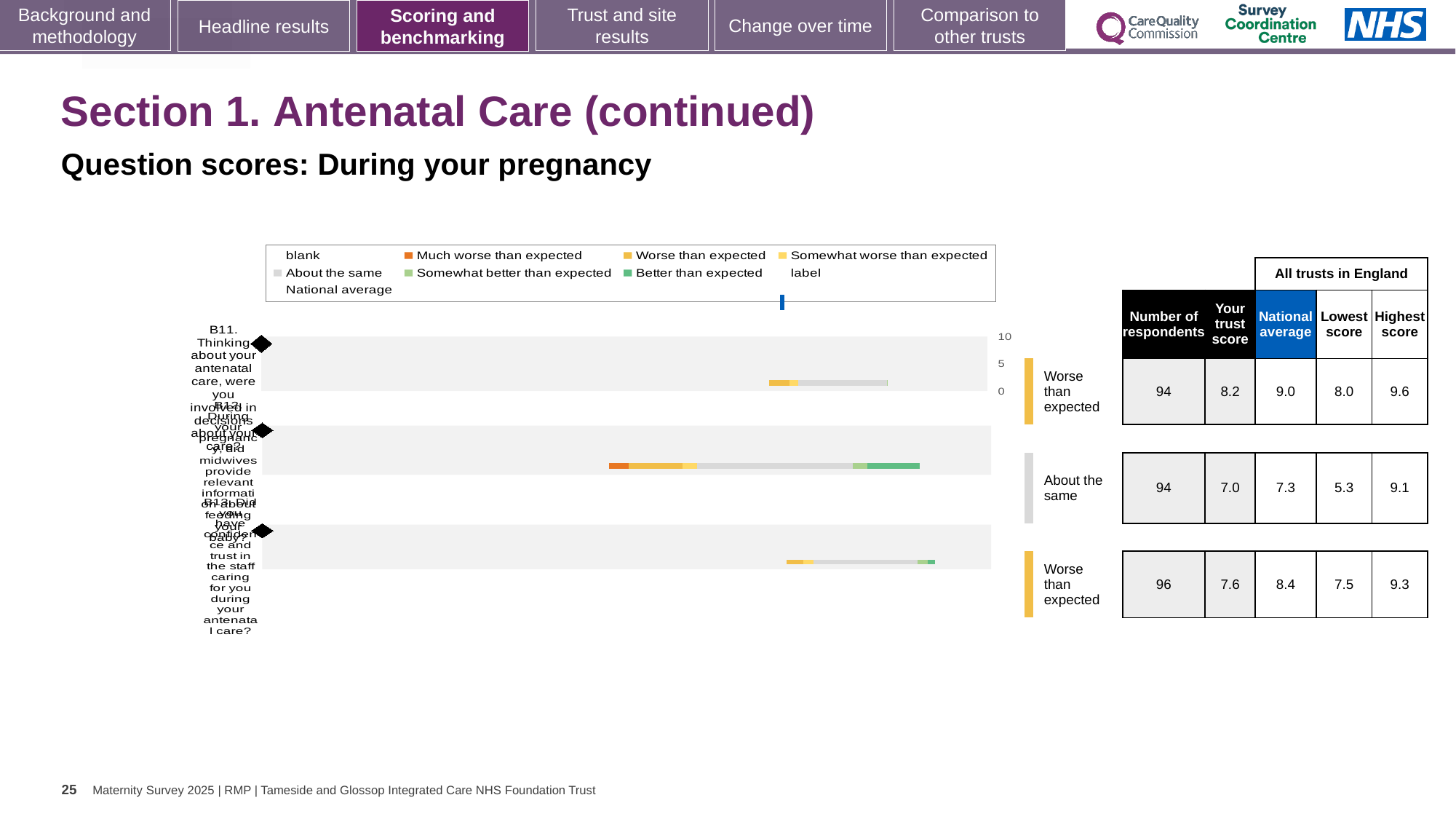
What colour does the legend use for 'Better than expected'? green Which question row has the highest 'Your trust score' in the table beside the chart? B11 In the table beside the chart, what is the National average for the second row (B12, midwives provide relevant information about feeding your baby)? 7.3 What kind of chart is shown on the slide? bar chart For the first row (B11), what is the difference between the National average and the 'Your trust score'? 0.8 In the table beside the chart, what is the 'Your trust score' for the first row (B11, involved in decisions about your care)? 8.2 How many question rows (categories) does the chart show? 3 What benchmark label is shown next to the second row (B12) of the chart? About the same For the third row (B13), which is larger: the 'Your trust score' or the National average? National average Which question row has the lowest 'Lowest score' in the table beside the chart? B12 In the table beside the chart, what is the Number of respondents for the third row (B13, confidence and trust in the staff)? 96 How many entries does the chart's legend list? 9